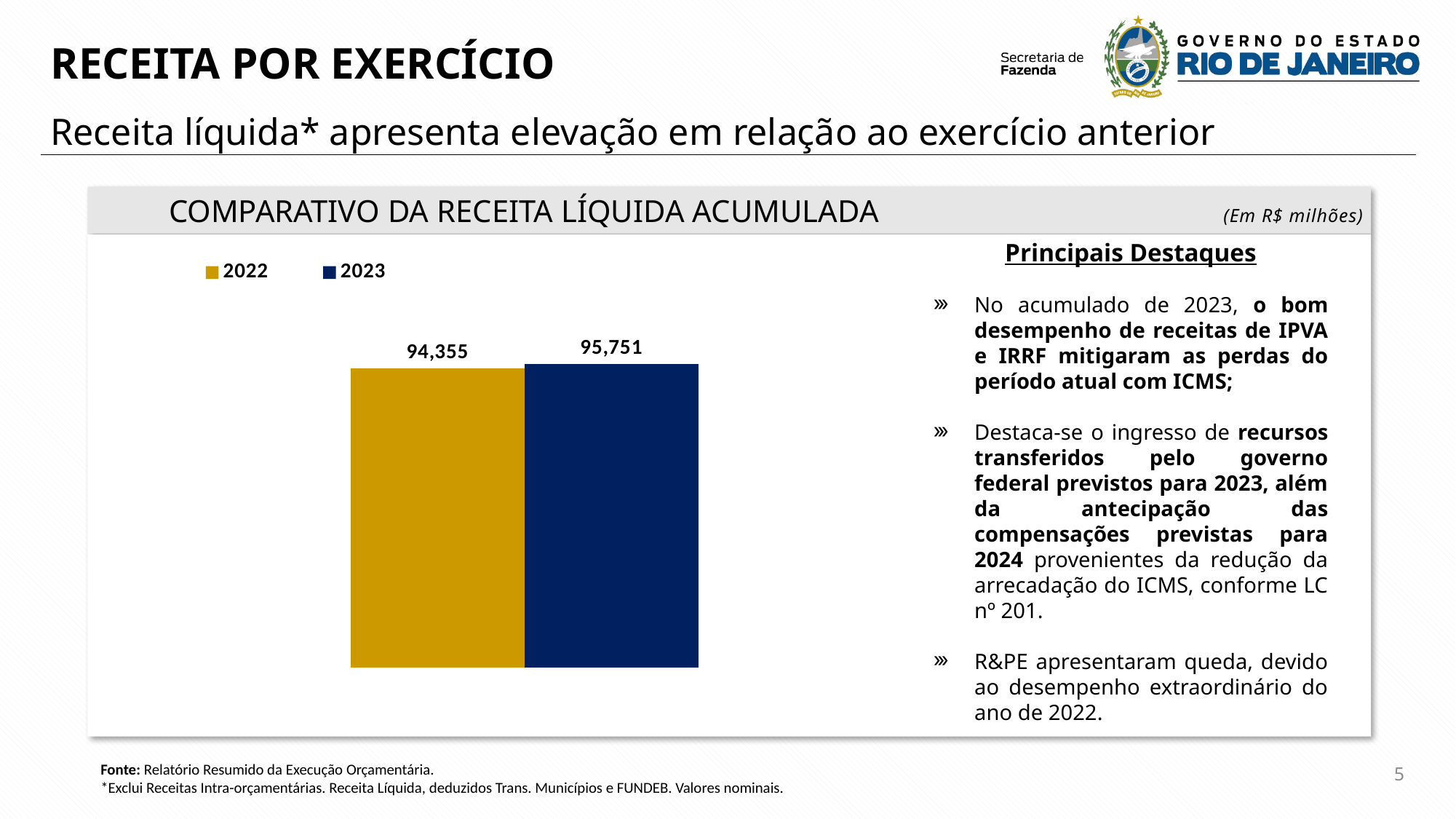
What is the difference between the 2023 and 2022 values in the chart? 1,396 Do the values rise or fall from 2022 to 2023? rise What is the value for 2022 in the chart? 94,355 Is the value for 2023 larger or smaller than the value for 2022? larger What is the value for 2023 in the chart? 95,751 How many bars are plotted in the chart? 2 What kind of chart is shown on the slide? bar chart What is the title of the chart? COMPARATIVO DA RECEITA LÍQUIDA ACUMULADA How many series does the chart legend list? 2 Which year has the lower value in the chart? 2022 Which year has the higher value in the chart? 2023 In what unit are the chart values expressed? R$ milhões